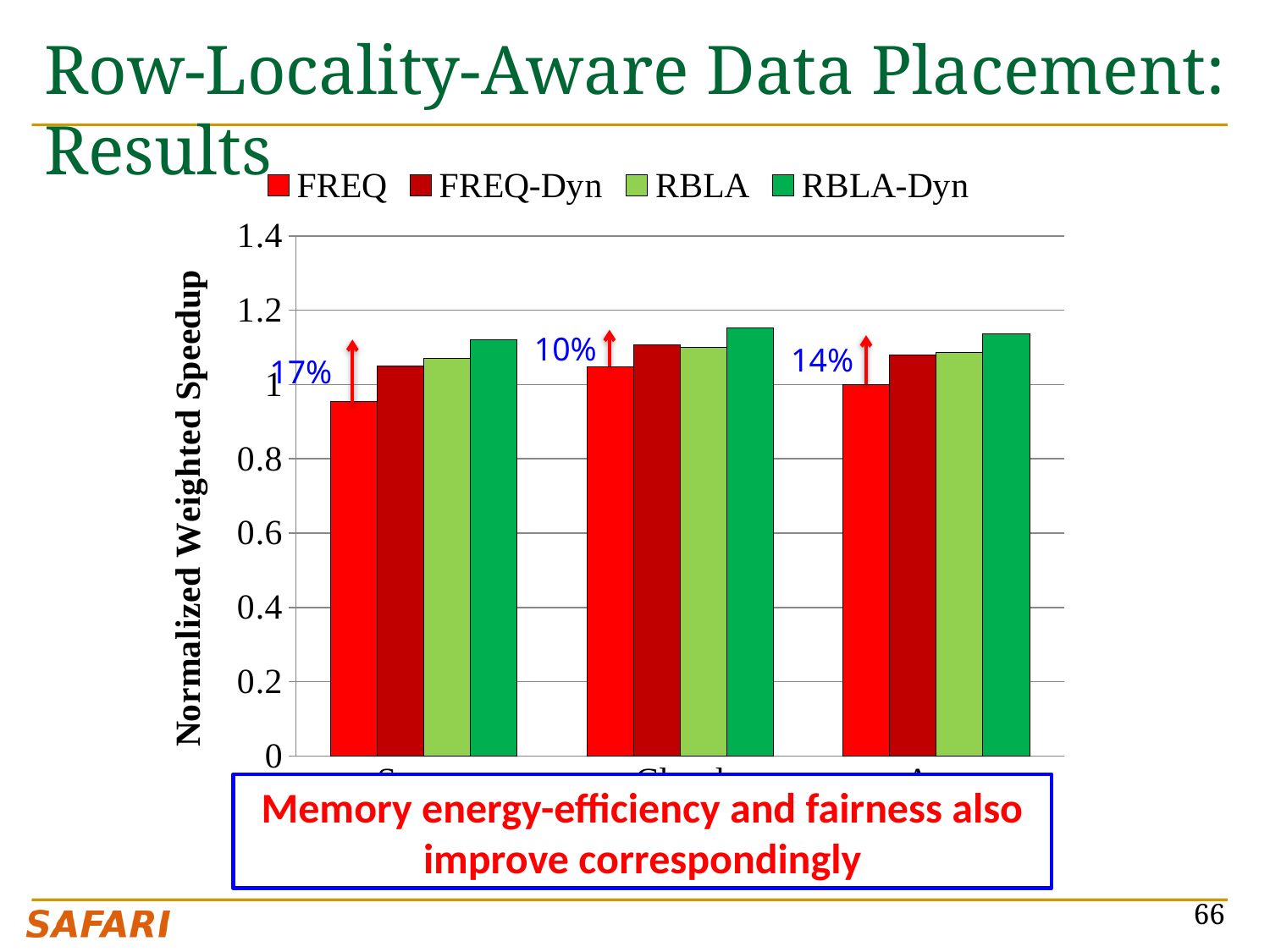
How many groups of bars are plotted along the x axis? 3 What are the series names listed in the legend? FREQ, FREQ-Dyn, RBLA, RBLA-Dyn In the second (middle) group of bars, which is larger: FREQ or RBLA-Dyn? RBLA-Dyn Which series has the lowest bar in the first (leftmost) group? FREQ What kind of chart is shown on the slide? bar chart Which series has the highest bar in the first (leftmost) group? RBLA-Dyn What percentage improvement is annotated above the first (leftmost) group of bars? 17% Is the RBLA-Dyn value in the first (leftmost) group of bars greater or less than 1.2? less Is the FREQ value in the first (leftmost) group of bars greater or less than 1? less Is the RBLA-Dyn value in the third (rightmost) group of bars greater or less than 1? greater What is the y-axis title of the chart? Normalized Weighted Speedup How many series does the legend list? 4